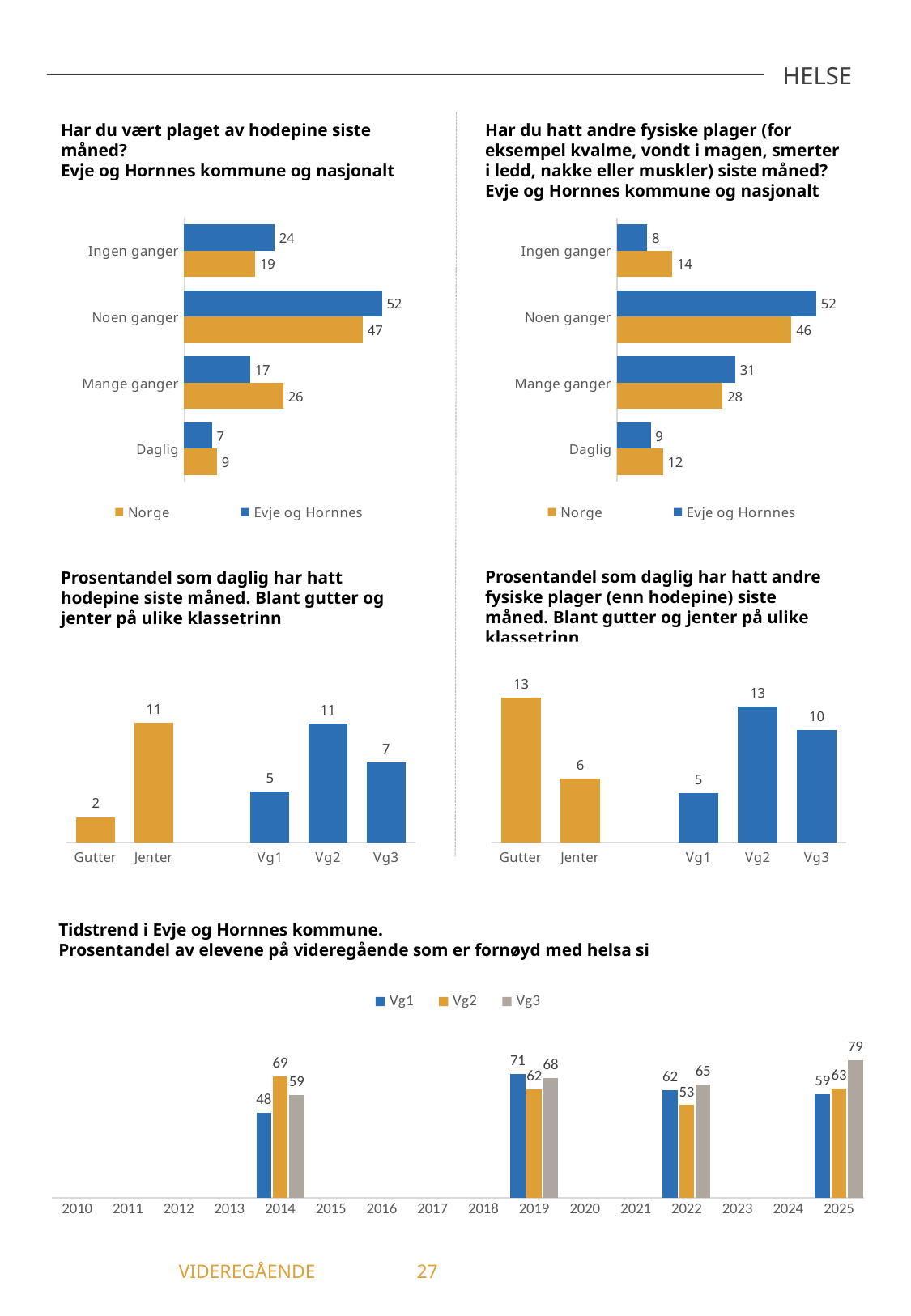
How many series does the legend list in the chart 'Har du hatt andre fysiske plager ... siste måned?'? 2 In the chart 'Tidstrend i Evje og Hornnes kommune', what is the difference between Vg2 and Vg1 in 2014? 21 In the chart 'Prosentandel som daglig har hatt andre fysiske plager (enn hodepine) siste måned', what is the value for Vg3? 10 In the chart 'Har du vært plaget av hodepine siste måned?', what is the value for Evje og Hornnes in the 'Noen ganger' category? 52 In the chart 'Har du vært plaget av hodepine siste måned?', what is the difference between Norge and Evje og Hornnes for 'Mange ganger'? 9 In the chart 'Tidstrend i Evje og Hornnes kommune', what is the value for Vg3 in 2025? 79 In the chart 'Har du hatt andre fysiske plager ... siste måned?', what is the value for Norge in the 'Ingen ganger' category? 14 In the chart 'Prosentandel som daglig har hatt hodepine siste måned', what is the value for Gutter? 2 In the chart 'Prosentandel som daglig har hatt andre fysiske plager (enn hodepine) siste måned', which is larger, Gutter or Jenter? Gutter What kind of chart is 'Tidstrend i Evje og Hornnes kommune'? Bar chart In the chart 'Har du hatt andre fysiske plager ... siste måned?', which category has the highest value for Evje og Hornnes? Noen ganger In the chart 'Prosentandel som daglig har hatt hodepine siste måned', which category has the lowest value? Gutter